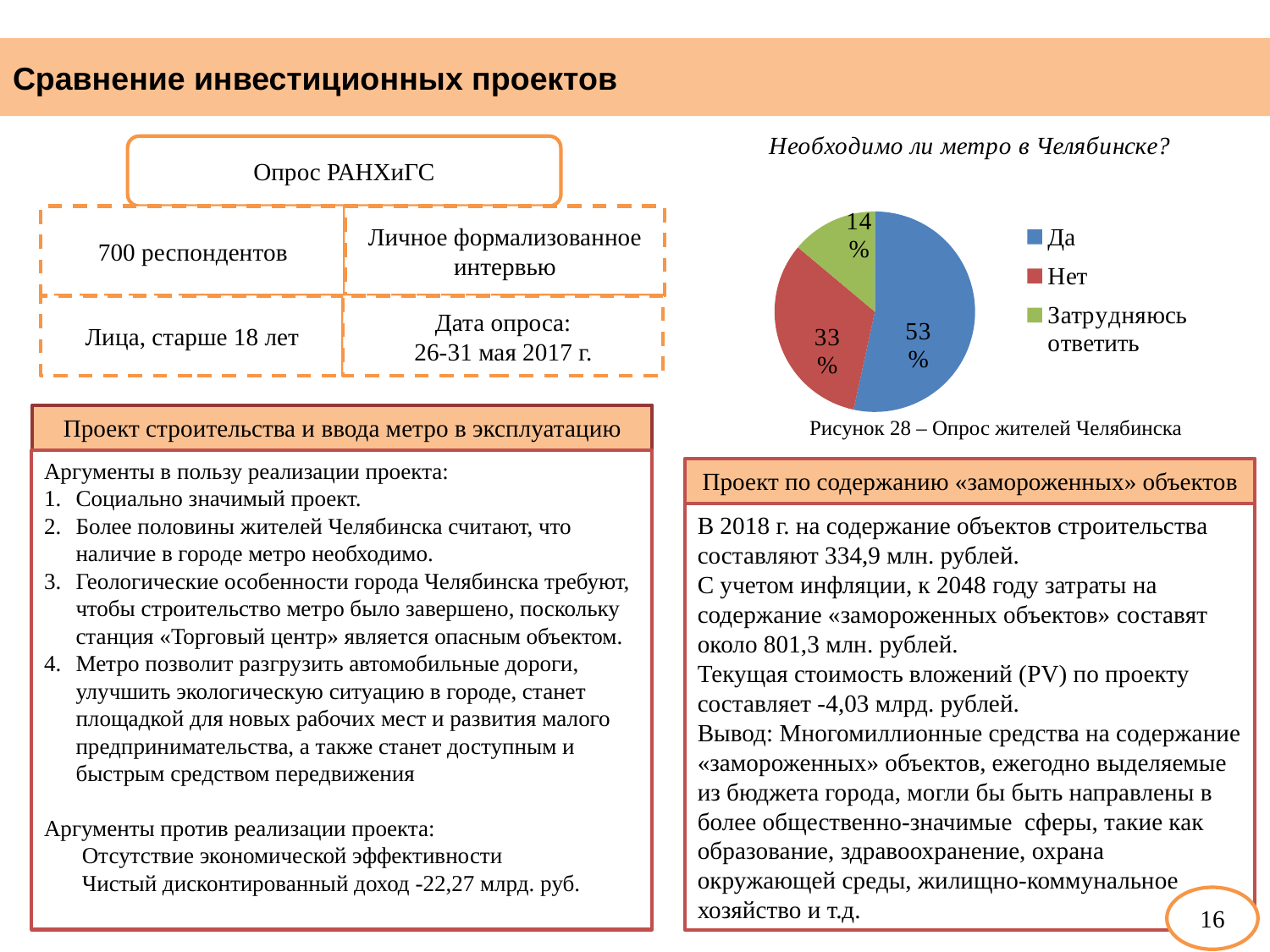
How many entries does the legend of the pie chart list? 3 Which slice is larger in the pie chart: "Нет" or "Затрудняюсь ответить"? Нет By how many percentage points does "Да" exceed "Нет" in the pie chart? 20 What is the title of the pie chart? Необходимо ли метро в Челябинске? How many slices does the pie chart have? 3 What share of respondents answered "Да" in the pie chart? 53% What type of chart is shown on the slide? pie chart What share of respondents answered "Нет" in the pie chart? 33% By how many percentage points does "Нет" exceed "Затрудняюсь ответить" in the pie chart? 19 What share of respondents answered "Затрудняюсь ответить" in the pie chart? 14% Which answer has the smallest slice in the pie chart? Затрудняюсь ответить Which answer has the largest slice in the pie chart? Да